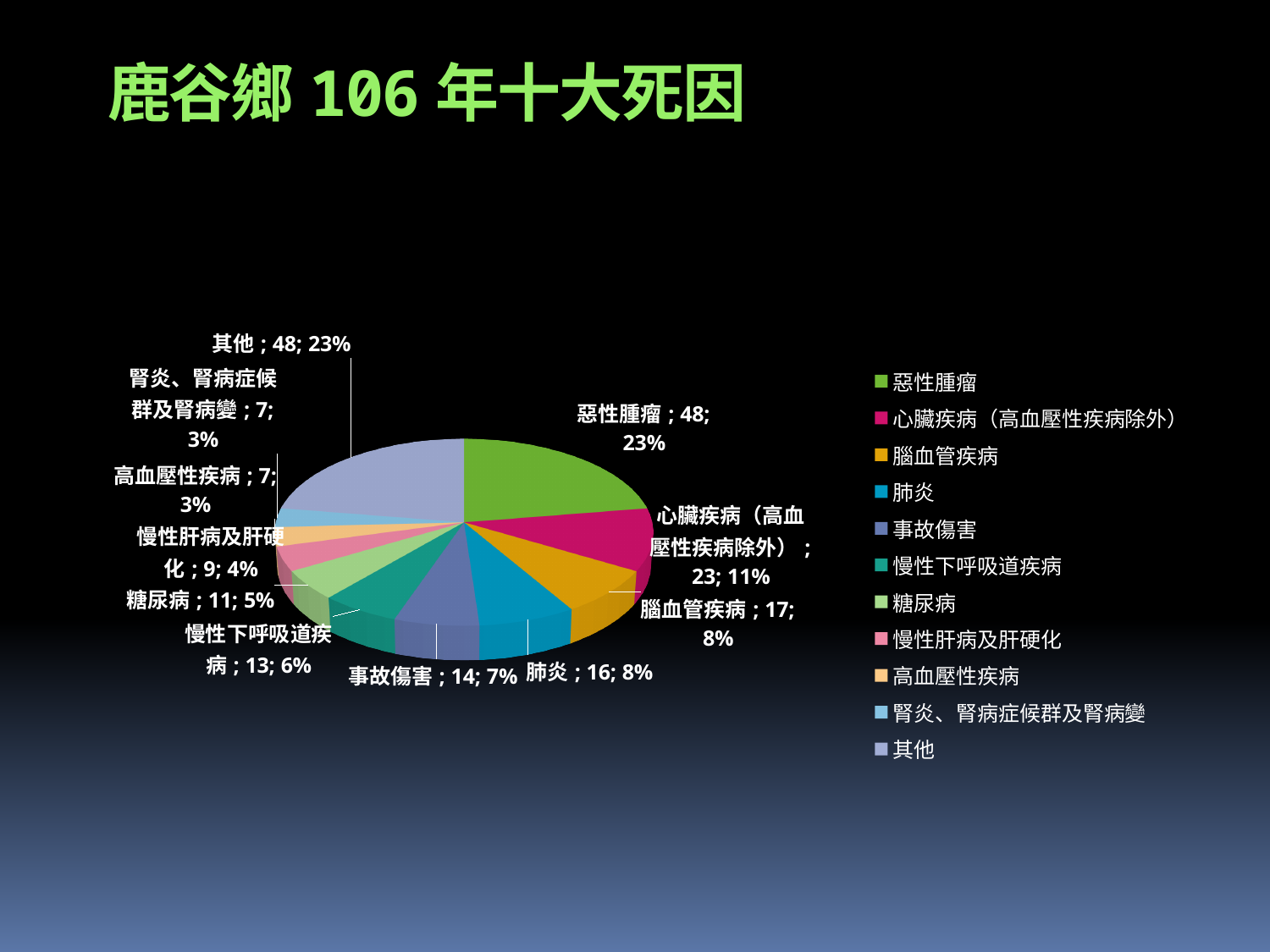
What is the title of the slide containing the chart? 鹿谷鄉 106 年十大死因 How many deaths are attributed to 惡性腫瘤 in the pie chart? 48 What is the value shown for 肺炎? 16 How many categories does the legend list? 11 What is the value shown for 事故傷害? 14 What is the value shown for 腦血管疾病? 17 What type of chart is shown on the slide? pie chart What percentage share does 其他 have in the pie chart? 23% What is the difference between the values for 惡性腫瘤 and 心臟疾病（高血壓性疾病除外）? 25 What percentage share does 慢性肝病及肝硬化 have in the pie chart? 4% What percentage share does 心臟疾病（高血壓性疾病除外） have in the pie chart? 11% Which has a larger value, 糖尿病 or 慢性下呼吸道疾病? 慢性下呼吸道疾病